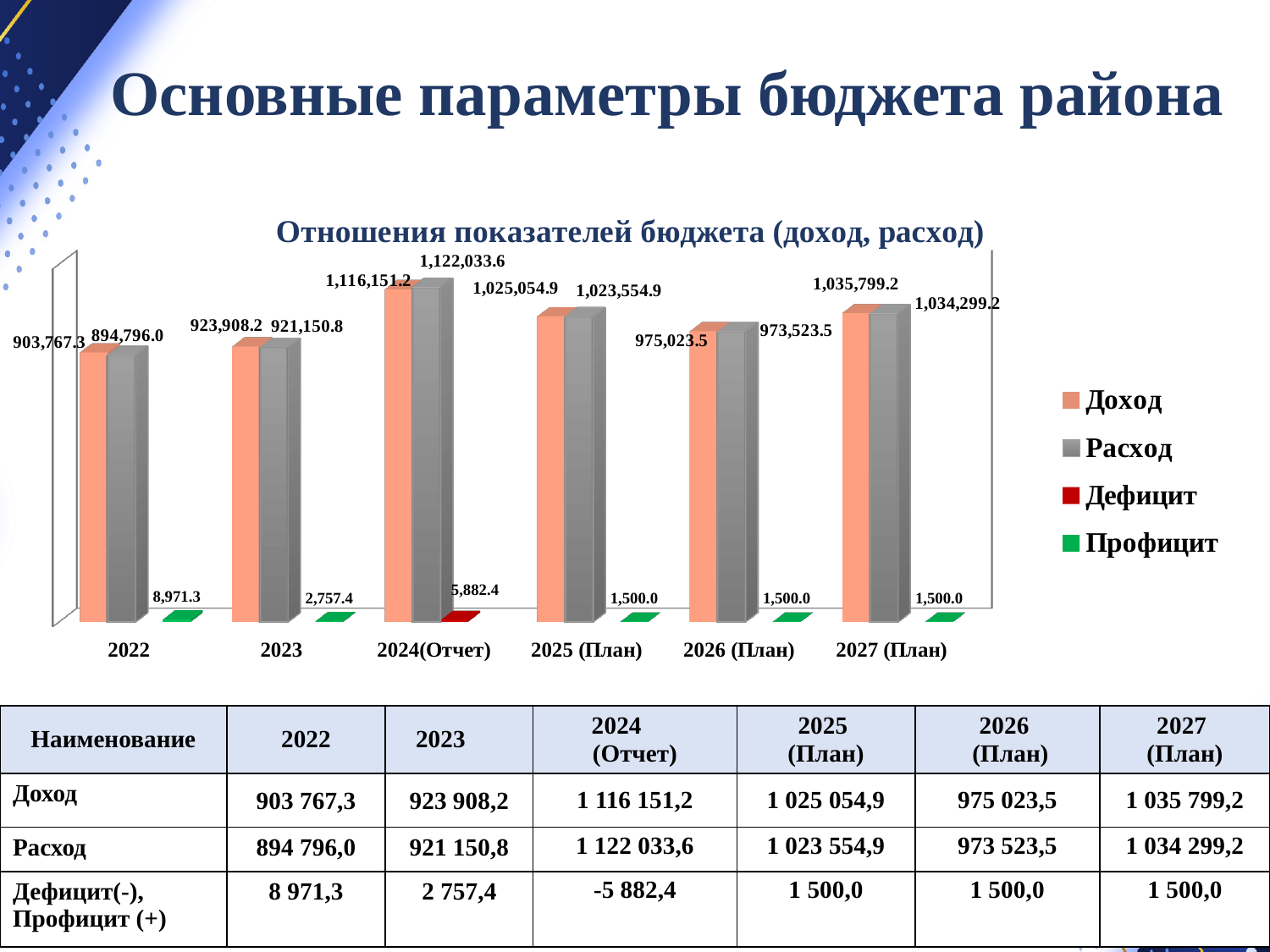
Which is larger for 2024(Отчет): Доход or Расход? Расход In which category is Расход the lowest? 2022 What is the value of Доход for 2026 (План) in the chart? 975,023.5 How many series does the chart legend list? 4 In which category is Доход the highest? 2024(Отчет) What is the difference between Доход and Расход for 2022? 8,971.3 What is the title of the chart? Отношения показателей бюджета (доход, расход) What kind of chart is shown on the slide? Bar chart What is the value of Доход for 2022 in the chart? 903,767.3 Which is larger for 2027 (План): Доход or Расход? Доход What is the value of Расход for 2024(Отчет) in the chart? 1,122,033.6 How many categories are shown on the x axis of the chart? 6